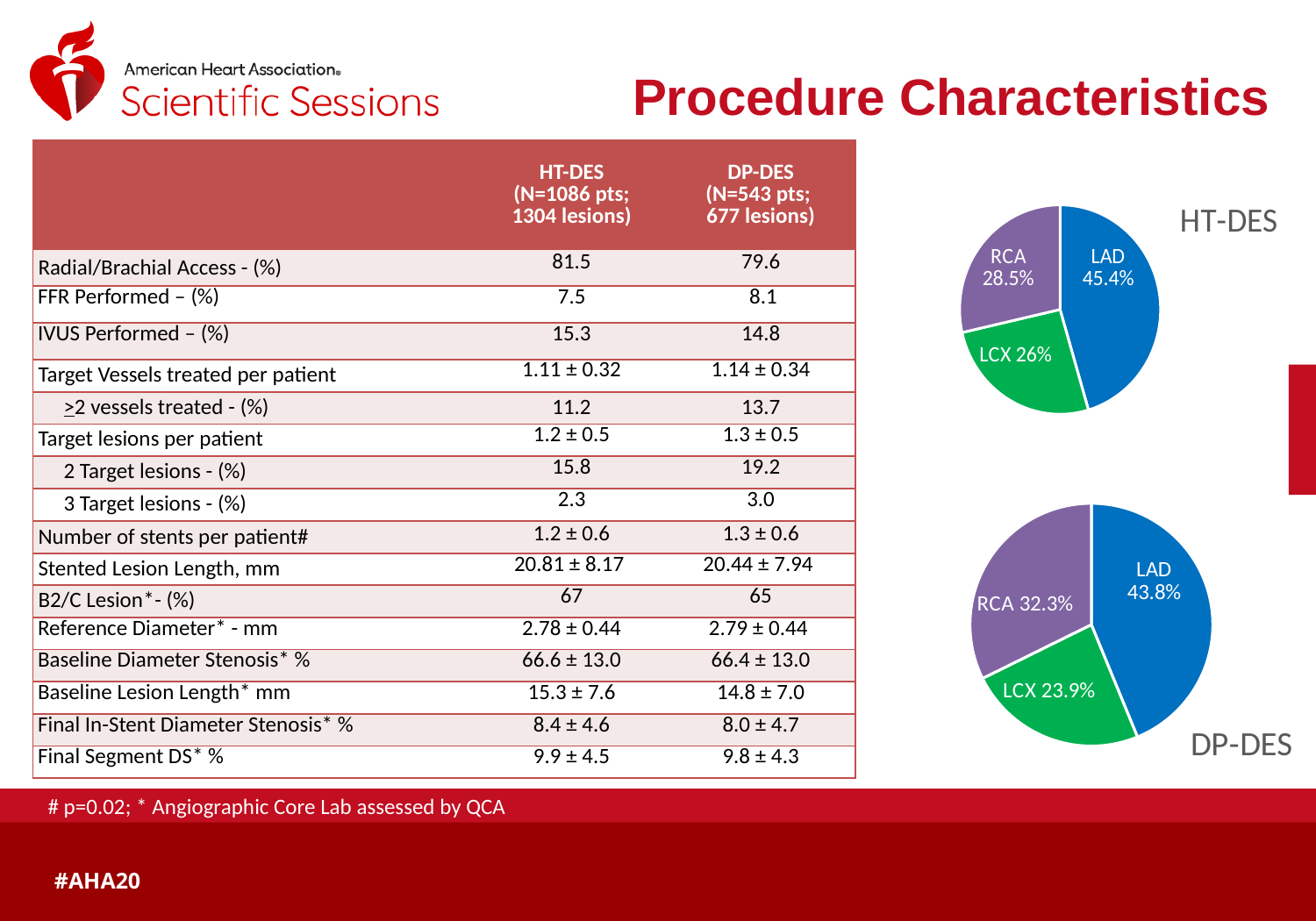
In the HT-DES pie chart, which is larger, the RCA share or the LCX share? RCA How many slices does the DP-DES pie chart have? 3 In the DP-DES pie chart, what share does RCA have? 32.3% In the DP-DES pie chart, which vessel has the smallest share? LCX In the DP-DES pie chart, what share does LAD have? 43.8% In the DP-DES pie chart, what is the difference between the LAD and RCA shares? 11.5% What type of chart is the HT-DES chart? Pie chart In the HT-DES pie chart, which vessel has the largest share? LAD In the HT-DES pie chart, what share does LCX have? 26% In the HT-DES pie chart, what share does RCA have? 28.5% In the DP-DES pie chart, what share does LCX have? 23.9% In the HT-DES pie chart, what share does LAD have? 45.4%